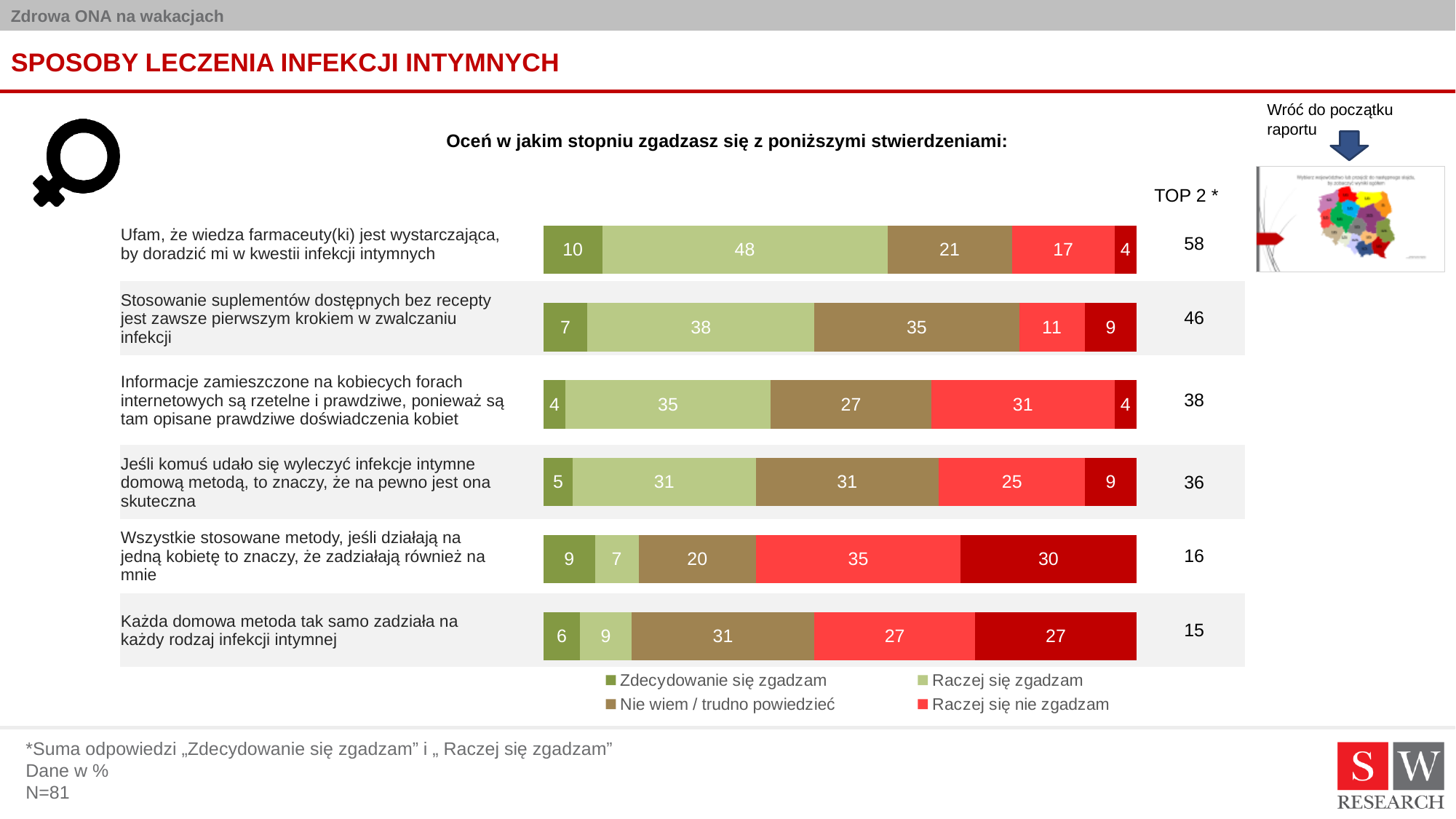
Which statement has the highest TOP 2 value? Ufam, że wiedza farmaceuty(ki) jest wystarczająca, by doradzić mi w kwestii infekcji intymnych What is the 'Nie wiem / trudno powiedzieć' value for the statement 'Stosowanie suplementów dostępnych bez recepty jest zawsze pierwszym krokiem w zwalczaniu infekcji'? 35 What is the 'Raczej się zgadzam' value for the statement 'Ufam, że wiedza farmaceuty(ki) jest wystarczająca, by doradzić mi w kwestii infekcji intymnych'? 48 Which statement has the lowest TOP 2 value? Każda domowa metoda tak samo zadziała na każdy rodzaj infekcji intymnej Which is larger: the 'Raczej się nie zgadzam' value for 'Wszystkie stosowane metody, jeśli działają na jedną kobietę...' or for 'Każda domowa metoda tak samo zadziała...'? Wszystkie stosowane metody, jeśli działają na jedną kobietę to znaczy, że zadziałają również na mnie What is the sample size (N) stated on the slide? N=81 What is the 'Zdecydowanie się zgadzam' value for the statement 'Jeśli komuś udało się wyleczyć infekcje intymne domową metodą, to znaczy, że na pewno jest ona skuteczna'? 5 What kind of chart is shown on the slide? stacked bar chart What is the difference between the TOP 2 values of 'Ufam, że wiedza farmaceuty(ki) jest wystarczająca...' and 'Stosowanie suplementów dostępnych bez recepty...'? 12 How many series does the legend list? 4 How many statements (categories) are plotted in the chart? 6 What is the TOP 2 value for the statement 'Informacje zamieszczone na kobiecych forach internetowych są rzetelne i prawdziwe, ponieważ są tam opisane prawdziwe doświadczenia kobiet'? 38